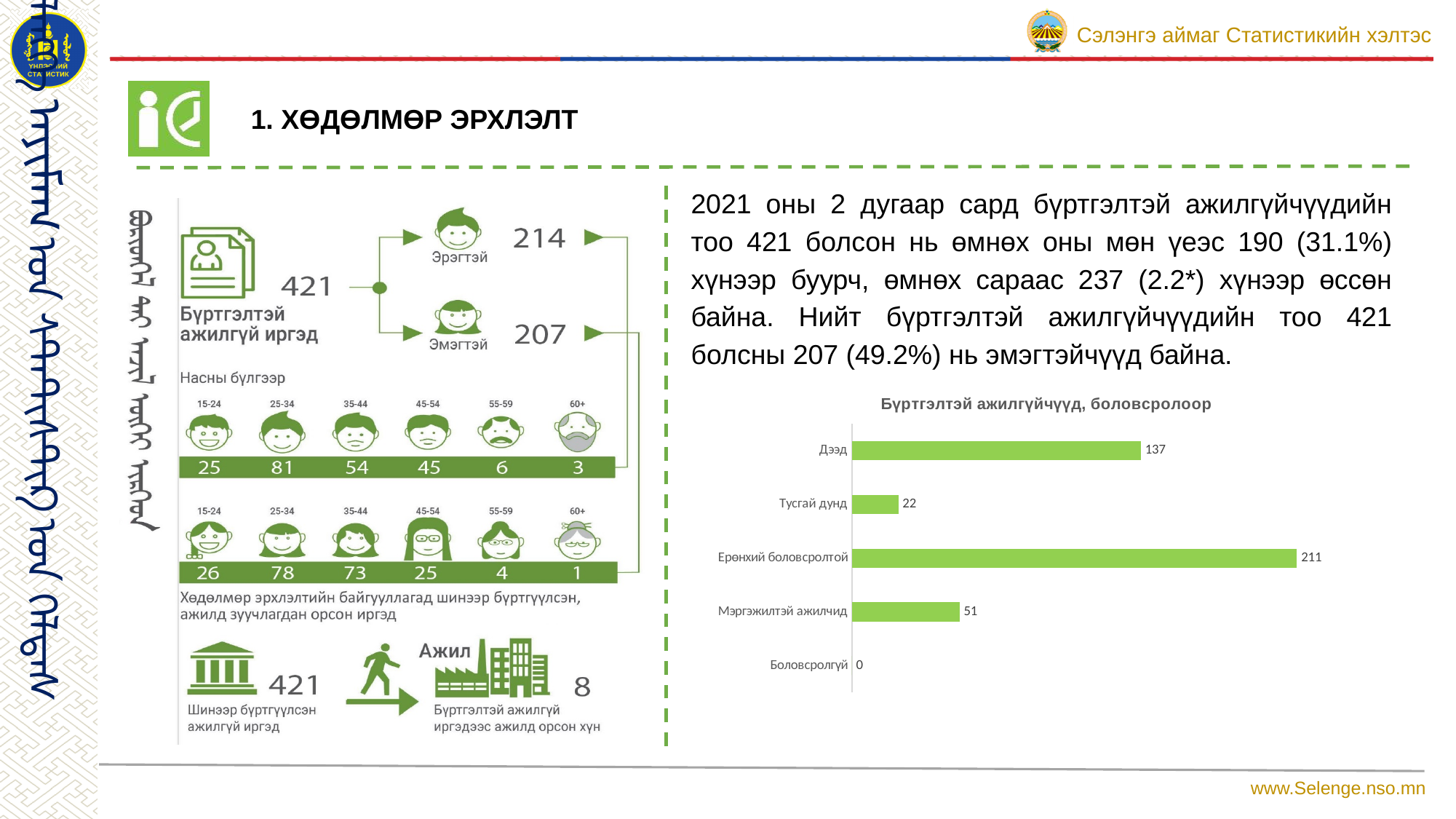
Which is larger, the value for Мэргэжилтэй ажилчид or the value for Тусгай дунд? Мэргэжилтэй ажилчид What kind of chart is "Бүртгэлтэй ажилгүйчүүд, боловсролоор"? bar chart What is the difference between the values for Ерөнхий боловсролтой and Дээд? 74 What is the title of the chart on the right side of the slide? Бүртгэлтэй ажилгүйчүүд, боловсролоор How many categories are shown in the chart? 5 What is the value for Ерөнхий боловсролтой in the chart? 211 What is the value for Тусгай дунд in the chart? 22 Which category has the lowest value in the chart? Боловсролгүй What is the value for Мэргэжилтэй ажилчид in the chart? 51 Which category has the highest value in the chart? Ерөнхий боловсролтой What is the value for Дээд in the chart "Бүртгэлтэй ажилгүйчүүд, боловсролоор"? 137 What is the value for Боловсролгүй in the chart? 0